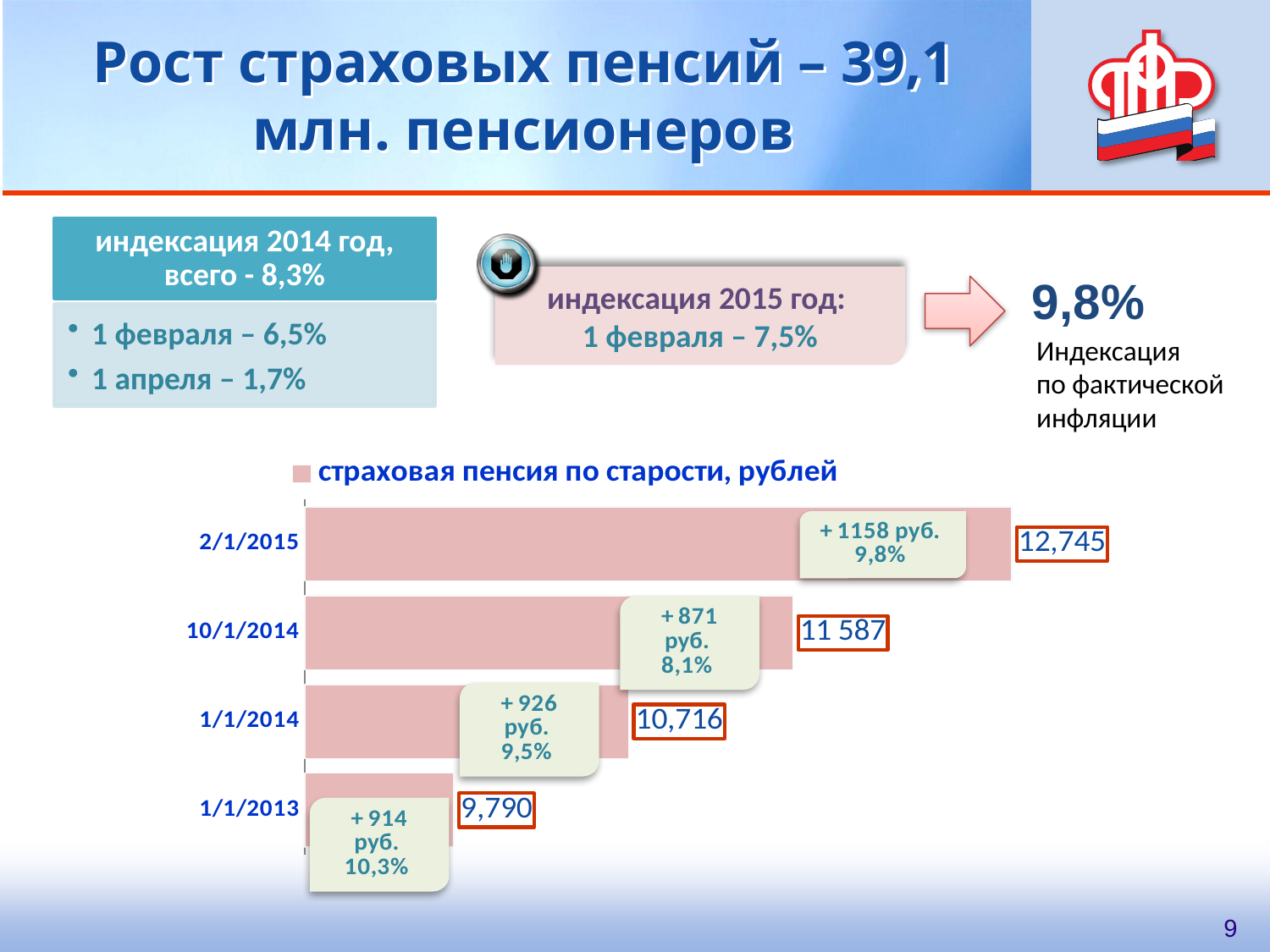
Which is larger, the value for 10/1/2014 or the value for 1/1/2014? 10/1/2014 How many categories (bars) does the chart show? 4 Which category has the lowest value? 1/1/2013 What type of chart is shown on the slide? bar chart What is the value of the bar for 10/1/2014? 11 587 What is the value of the bar for 2/1/2015? 12,745 Which category has the highest value? 2/1/2015 What is the legend entry of the chart? страховая пенсия по старости, рублей What is the value of the bar for 1/1/2014? 10,716 What is the difference between the values for 2/1/2015 and 10/1/2014? 1158 What is the value of the bar for 1/1/2013? 9,790 What is the difference between the values for 1/1/2014 and 1/1/2013? 926